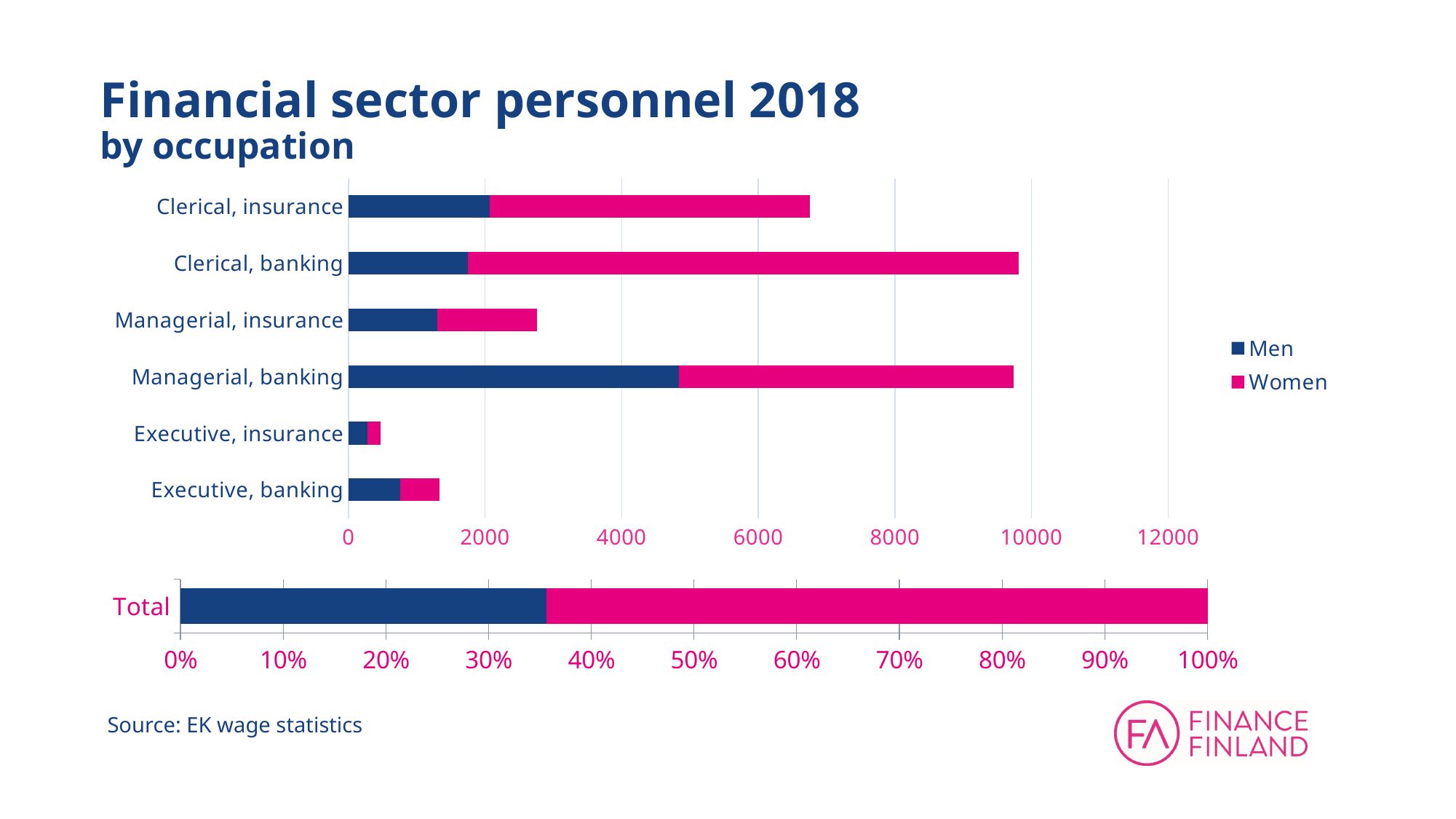
In the top chart by occupation, which has the longer total bar: Executive, banking or Executive, insurance? Executive, banking What kind of chart is the top chart by occupation? Stacked bar chart In the top chart by occupation, which colour represents Women in the legend? Pink In the top chart by occupation, is the total bar for Clerical, insurance greater or less than 6000? greater In the top chart by occupation, how many occupation categories are shown? 6 In the top chart by occupation, which occupation has the largest Women segment? Clerical, banking In the top chart by occupation, which occupation has the largest Men segment? Managerial, banking In the top chart by occupation, is the total bar for Managerial, insurance greater or less than 4000? less In the top chart by occupation, is the Men value for Managerial, banking greater or less than 4000? greater In the top chart by occupation, which occupation has the shortest total bar? Executive, insurance In the top chart by occupation, how many series does the legend list? 2